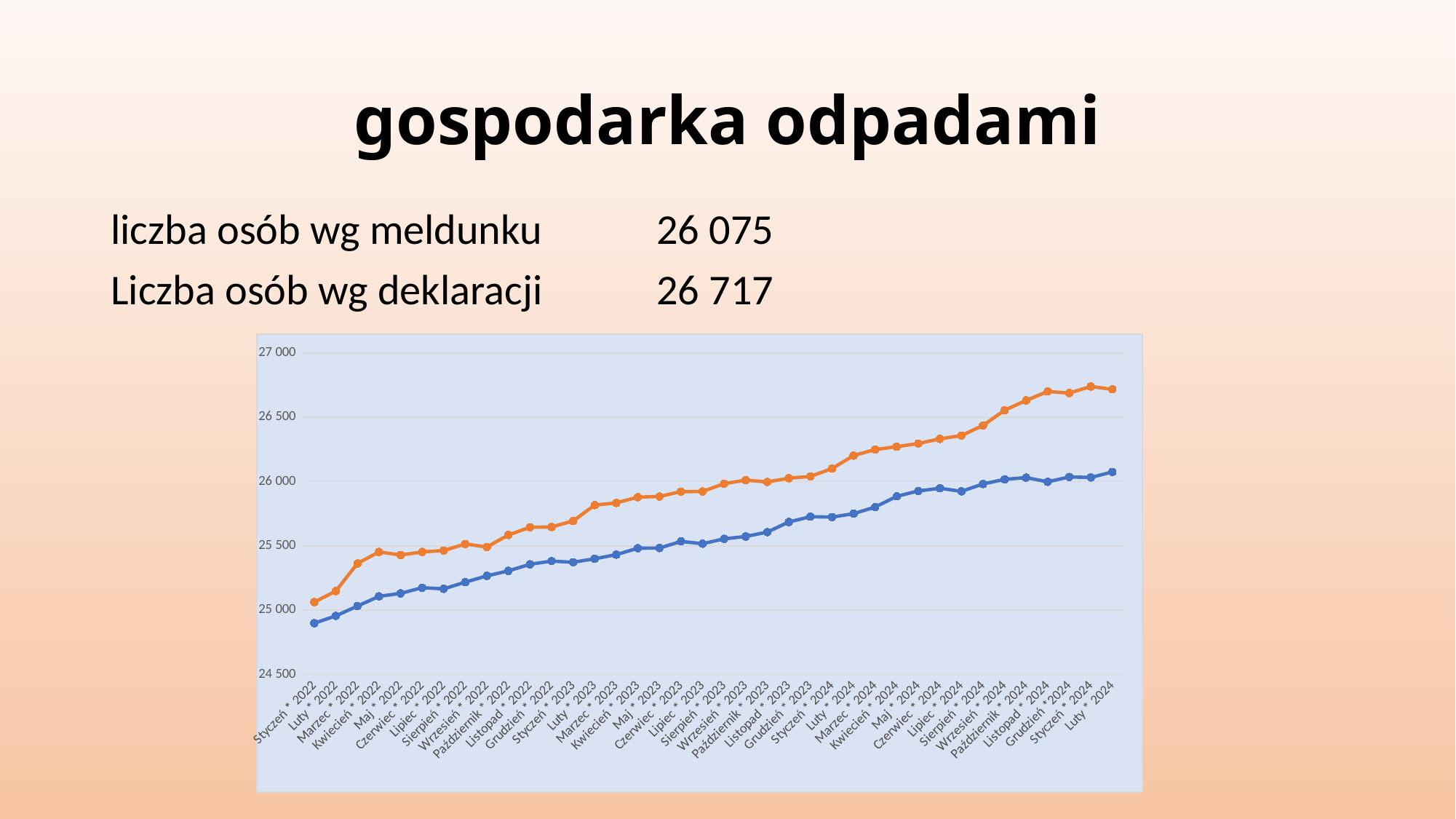
Is the value of the blue line in Grudzień 2022 greater or less than 25 500? less How many monthly data points are plotted along the x axis of the chart? 38 Do the values of the blue line rise or fall from Styczeń 2022 to Luty 2024? rise Which month is the last category on the x axis of the chart? Luty 2024 What kind of chart is shown on the slide? line chart Which line has the higher value in Luty 2024, the orange line or the blue line? orange line Is the value of the blue line in Styczeń 2022 greater or less than 25 000? less Which month is the first category on the x axis of the chart? Styczeń 2022 Do the values of the orange line rise or fall from Styczeń 2022 to Luty 2024? rise In which month does the blue line reach its lowest value? Styczeń 2022